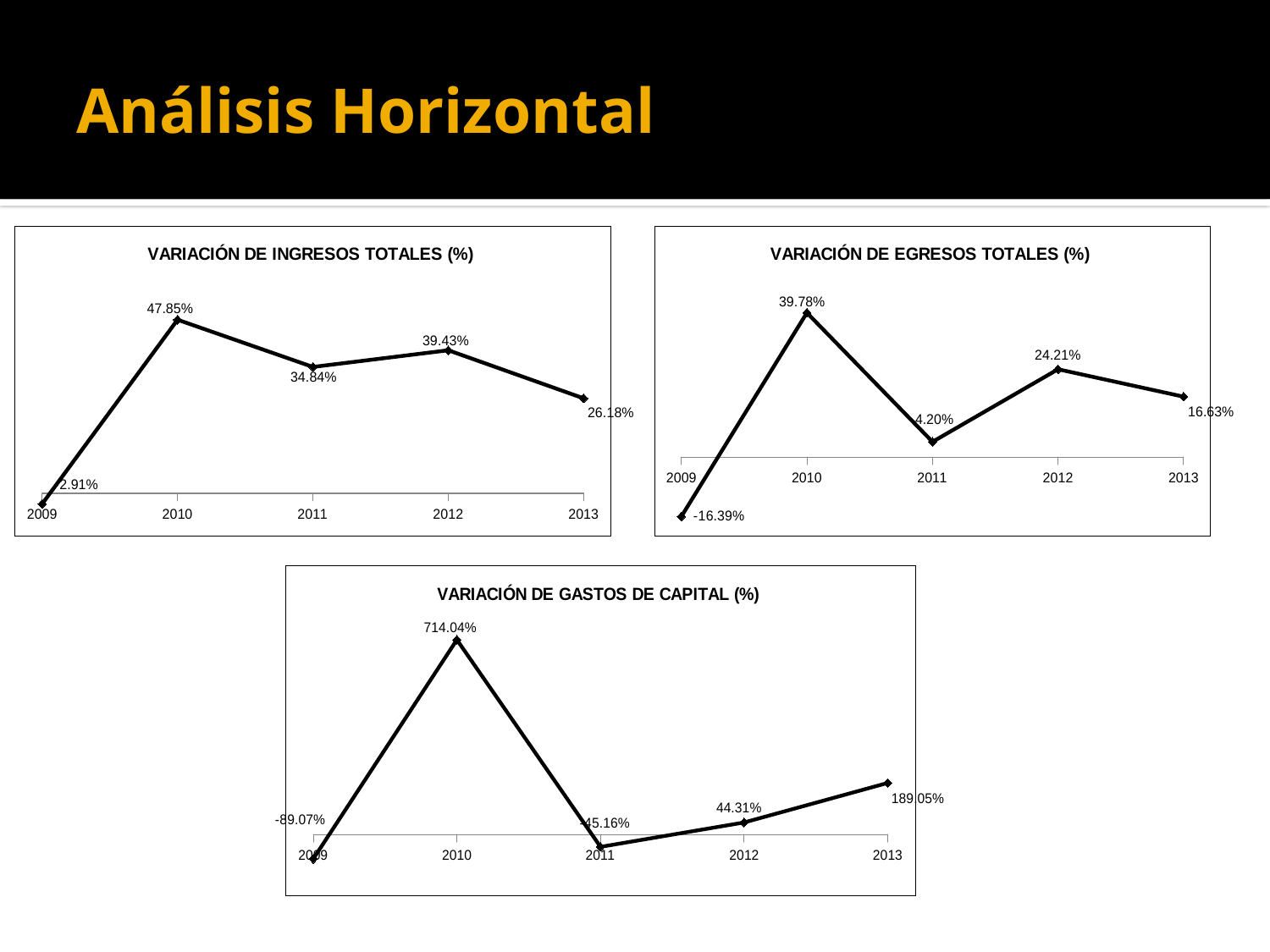
In the chart titled VARIACIÓN DE INGRESOS TOTALES (%), which year has the lowest value? 2009 In the chart titled VARIACIÓN DE INGRESOS TOTALES (%), how many years are plotted? 5 In the chart titled VARIACIÓN DE INGRESOS TOTALES (%), what is the difference between the 2012 and 2011 values? 4.59% In the chart titled VARIACIÓN DE GASTOS DE CAPITAL (%), what is the value for 2010? 714.04% In the chart titled VARIACIÓN DE EGRESOS TOTALES (%), what is the value for 2009? -16.39% In the chart titled VARIACIÓN DE EGRESOS TOTALES (%), which year has the highest value? 2010 In the chart titled VARIACIÓN DE INGRESOS TOTALES (%), what is the value for 2010? 47.85% In the chart titled VARIACIÓN DE EGRESOS TOTALES (%), which is larger, the value for 2012 or the value for 2013? 2012 What type of chart is the chart titled VARIACIÓN DE GASTOS DE CAPITAL (%)? line chart In the chart titled VARIACIÓN DE GASTOS DE CAPITAL (%), do the values rise or fall from 2011 to 2013? rise In the chart titled VARIACIÓN DE GASTOS DE CAPITAL (%), what is the value for 2013? 189.05% In the chart titled VARIACIÓN DE EGRESOS TOTALES (%), what is the difference between the 2010 and 2011 values? 35.58%